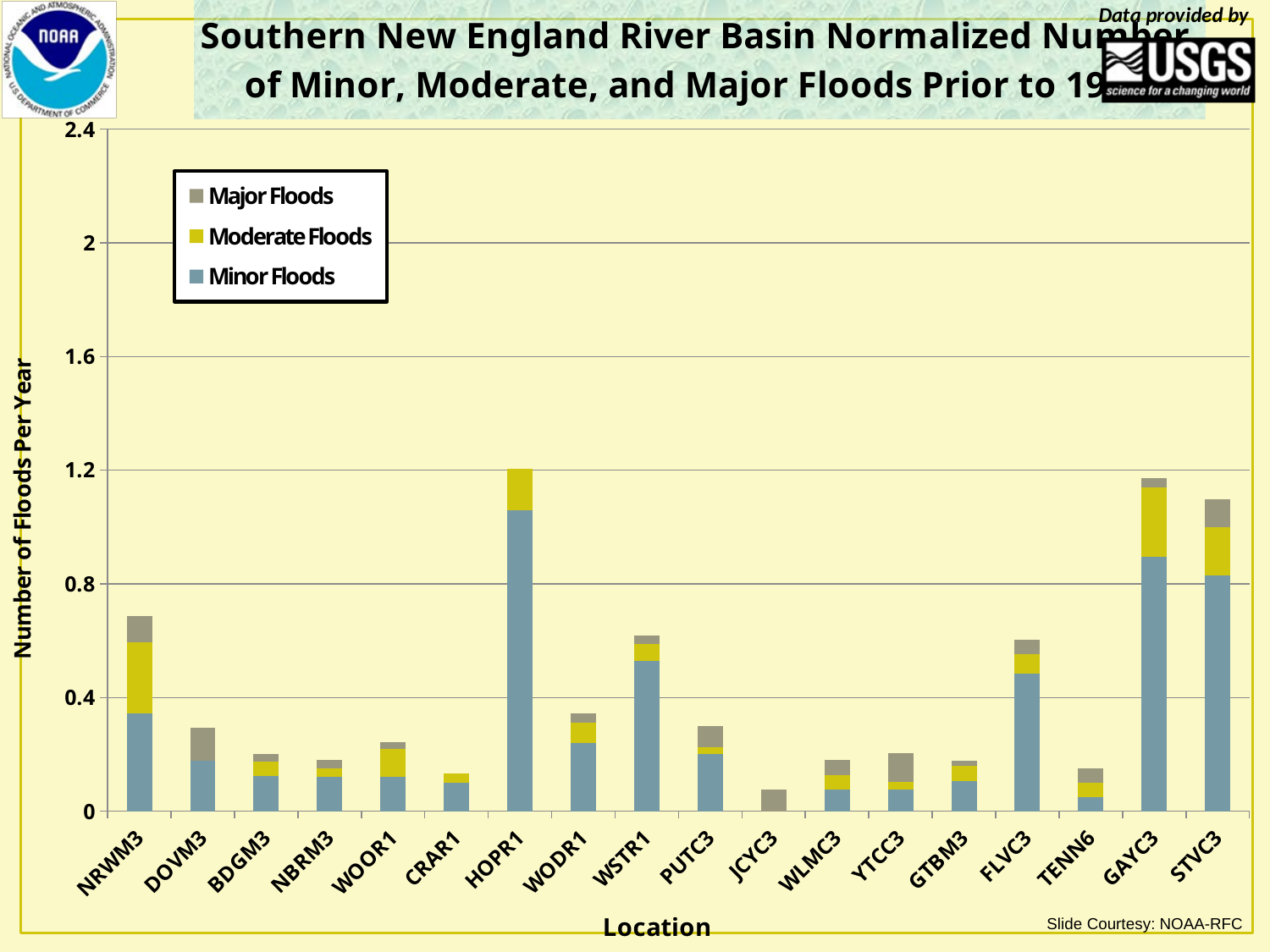
Is the total value for STVC3 greater or less than 0.8? greater Which series in the legend is shown in yellow? Moderate Floods Which has a larger total number of floods per year, GAYC3 or FLVC3? GAYC3 What is the title of the chart's y axis? Number of Floods Per Year What kind of chart is shown on the slide? Stacked bar chart Which location has the lowest total number of floods per year? JCYC3 Is the total value for HOPR1 greater or less than 1? greater Is the total value for DOVM3 greater or less than 0.4? less How many series does the chart's legend list? 3 How many locations are shown along the x axis of the chart? 18 Which has a larger total number of floods per year, HOPR1 or WSTR1? HOPR1